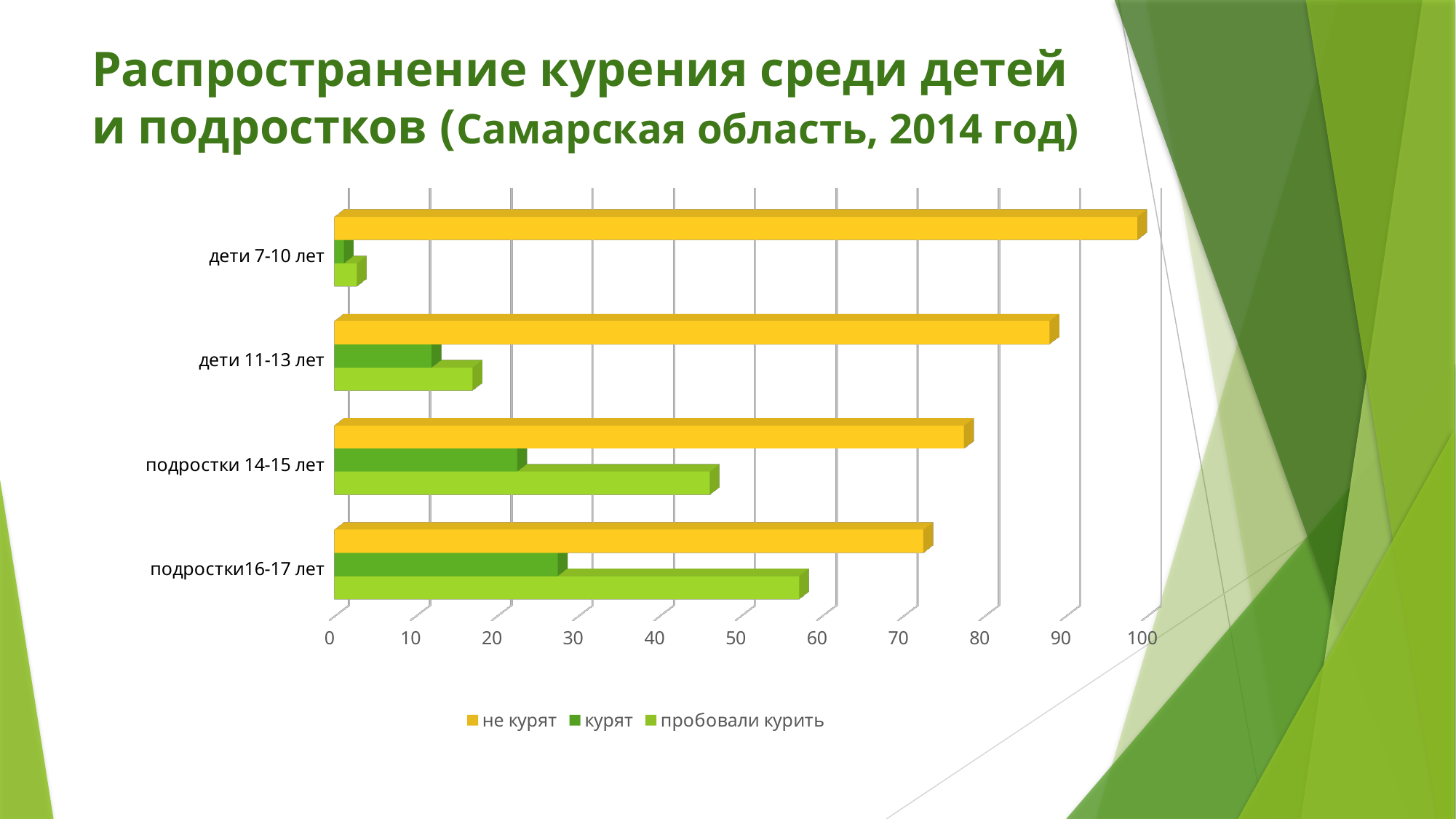
How many age groups (categories) are shown on the chart? 4 Which age group has the highest value for "не курят"? дети 7-10 лет Which age group has the highest value for "пробовали курить"? подростки16-17 лет What kind of chart is shown on the slide? bar chart Which age group has the lowest value for "курят"? дети 7-10 лет Is the value for "пробовали курить" among подростки 14-15 лет greater or less than 50? less Is the value for "курят" among дети 11-13 лет greater or less than 20? less Which is larger for подростки16-17 лет: "курят" or "пробовали курить"? пробовали курить Is the value for "не курят" among подростки16-17 лет greater or less than 70? greater Does the value for "не курят" rise or fall as the age groups get older (from дети 7-10 лет to подростки16-17 лет)? fall How many series does the legend list? 3 Which series is shown in yellow in the legend? не курят